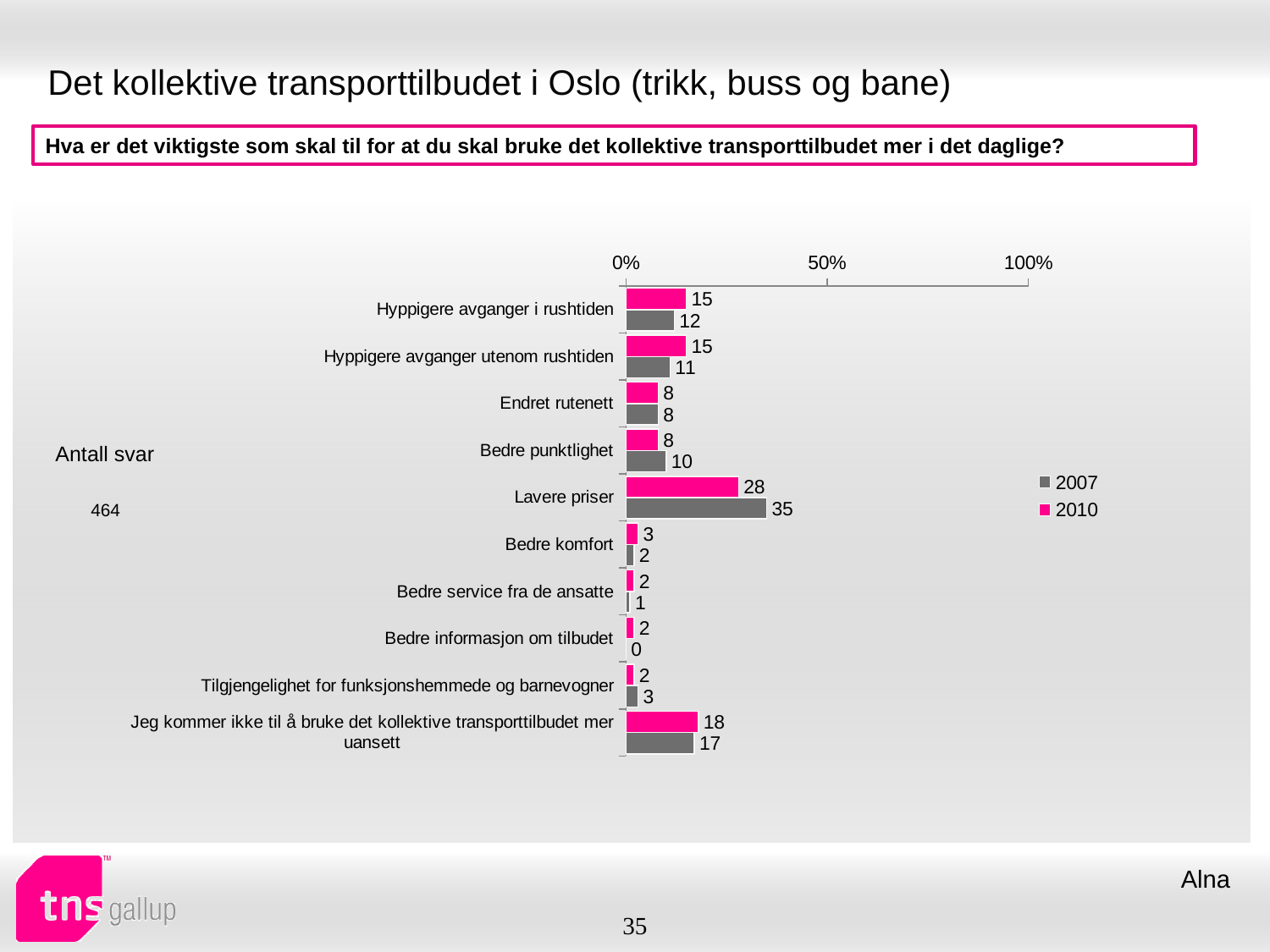
What is the 2010 value for Hyppigere avganger i rushtiden? 15 What is the 2007 value for Bedre informasjon om tilbudet? 0 What is the 2010 value for Jeg kommer ikke til å bruke det kollektive transporttilbudet mer uansett? 18 How many series does the legend list? 2 Which colour represents the 2010 series in the legend? Pink What kind of chart is shown on the slide? Bar chart Which category has the lowest 2007 value? Bedre informasjon om tilbudet Which category has the highest 2010 value? Lavere priser What is the 2007 value for Lavere priser? 35 For Bedre punktlighet, which year has the larger value, 2007 or 2010? 2007 How many categories are shown on the chart? 10 What is the difference between the 2007 and 2010 values for Lavere priser? 7